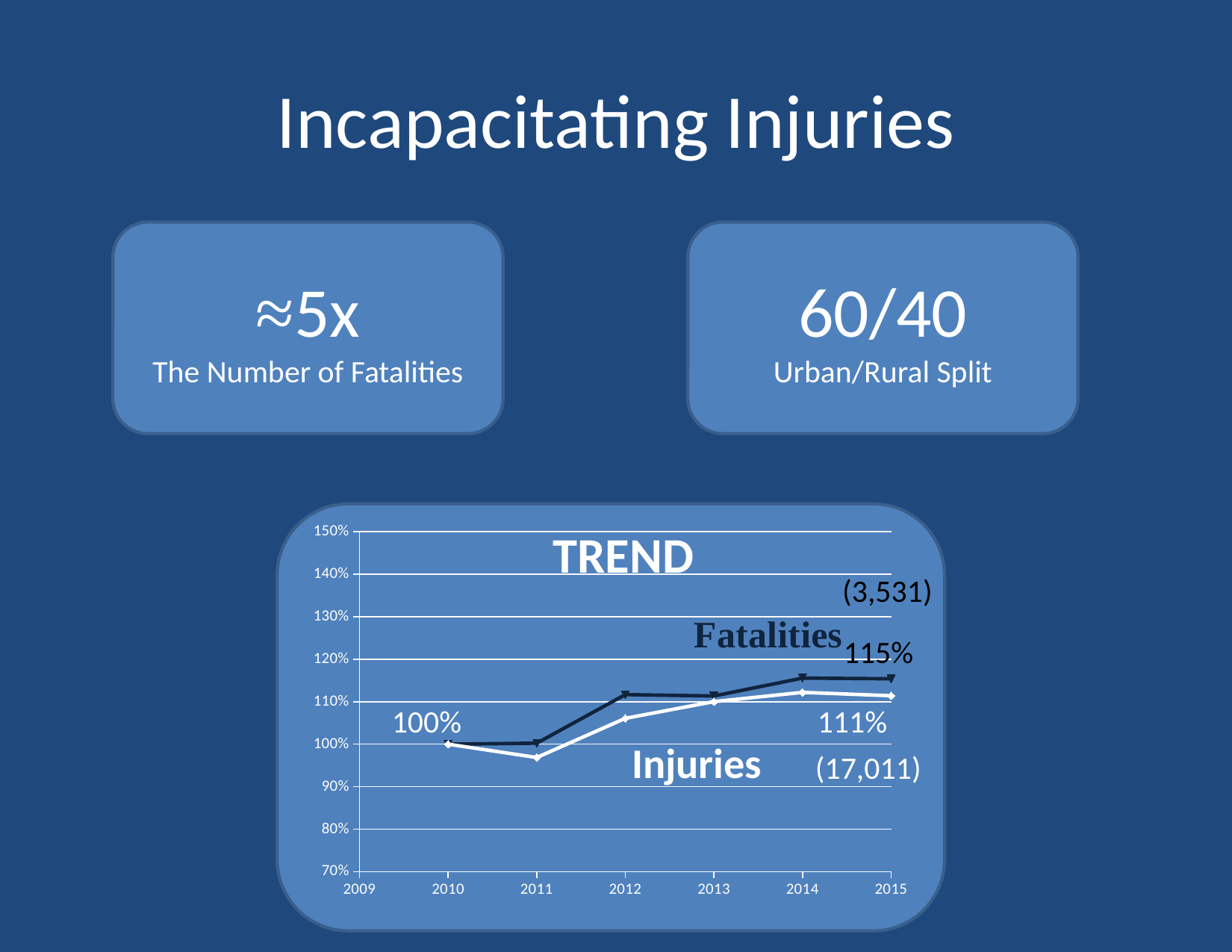
What is the difference between the Fatalities and Injuries values in 2015? 4 percentage points What is the value of both series in 2010? 100% In which year is the Injuries series at its lowest? 2011 Is the Fatalities value in 2014 greater or less than 110%? greater Is the Injuries value in 2011 greater or less than 100%? less Do the Fatalities values rise or fall from 2010 to 2015? rise What is the title of the chart? TREND What is the Injuries value in 2015? 111% What kind of chart is shown on the slide? line chart In 2015, which series has the higher value, Fatalities or Injuries? Fatalities What is the Fatalities value in 2015? 115% How many series are plotted in the chart? 2